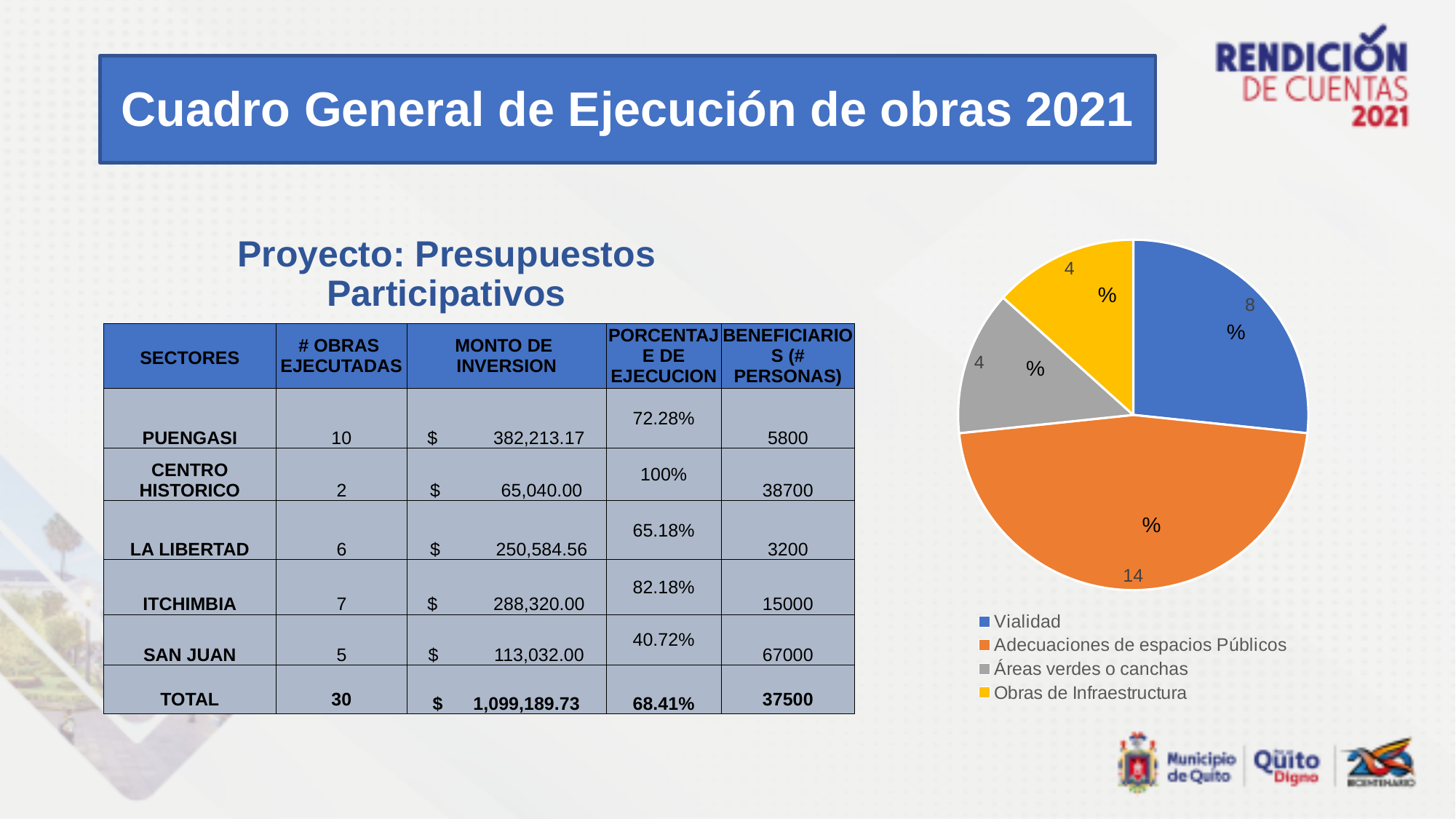
How many slices does the pie chart have? 4 What kind of chart is shown on the right side of the slide? pie chart Which category has the largest slice in the pie chart? Adecuaciones de espacios Públicos Which category is shown in yellow in the pie chart? Obras de Infraestructura What value is labelled on the Áreas verdes o canchas slice of the pie chart? 4 How many entries does the pie chart's legend list? 4 Which slice is larger in the pie chart, Vialidad or Adecuaciones de espacios Públicos? Adecuaciones de espacios Públicos What is the difference between the labelled values of the Adecuaciones de espacios Públicos slice and the Vialidad slice? 6 What value is labelled on the Vialidad slice of the pie chart? 8 What value is labelled on the Obras de Infraestructura slice of the pie chart? 4 What value is labelled on the Adecuaciones de espacios Públicos slice of the pie chart? 14 Which colour represents Vialidad in the pie chart? blue